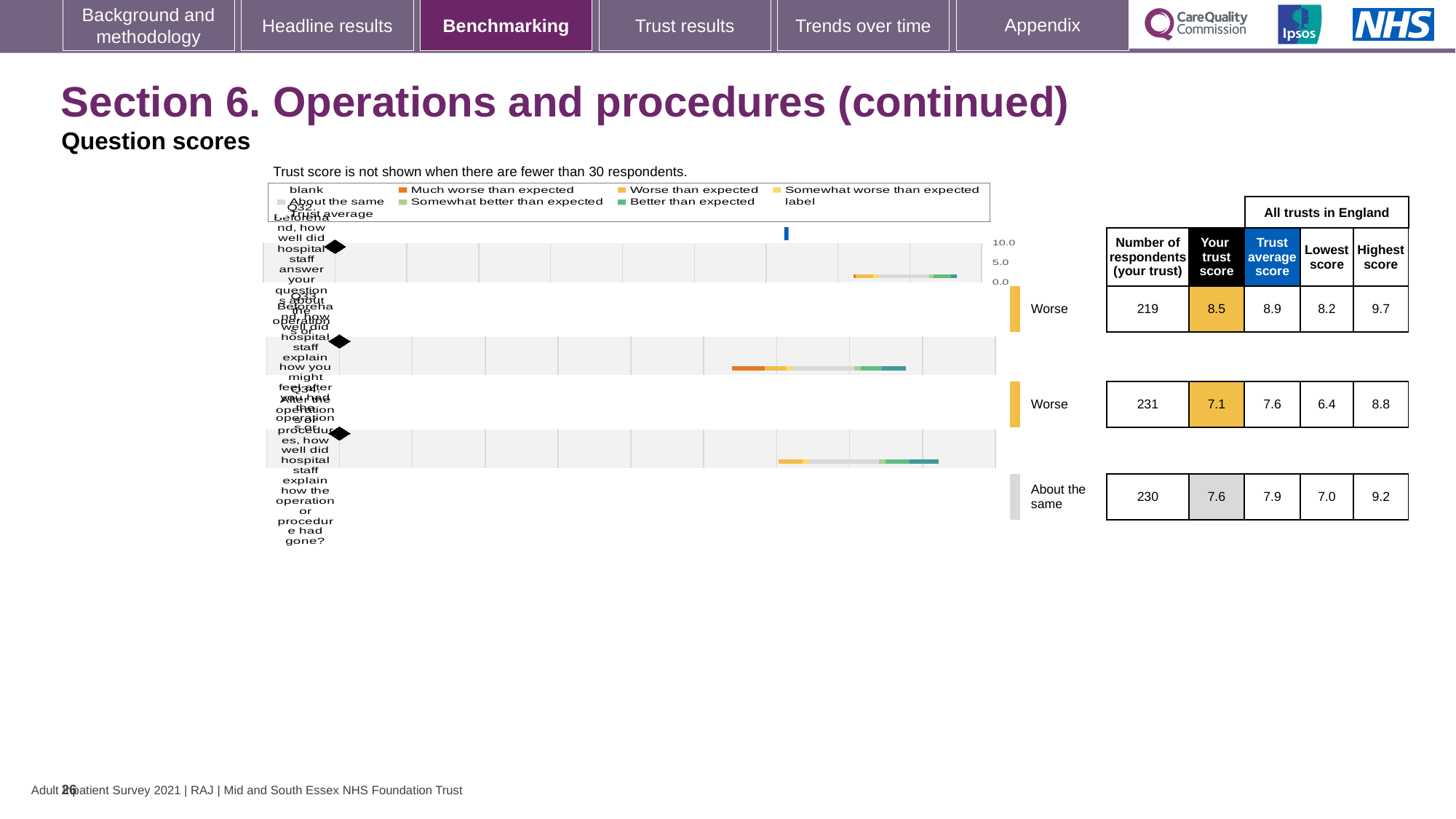
Which question row has the highest 'Your trust score'? The first row (8.5) What is the lowest score across all trusts in England for the second question row (231 respondents)? 6.4 What is the trust score for the first question row (219 respondents)? 8.5 According to the note above the chart, when is the trust score not shown? When there are fewer than 30 respondents What is the trust average score for the second question row (231 respondents)? 7.6 Is your trust score for the second question row larger or smaller than the trust average score? Smaller What is the difference between the trust average score and your trust score for the first question row? 0.4 How many question rows are shown in the chart? 3 What benchmark category is shown for the third question row? About the same What is the highest score across all trusts in England for the third question row (230 respondents)? 9.2 Which question row has the lowest 'Your trust score'? The second row (7.1) How many respondents does the second question row have? 231